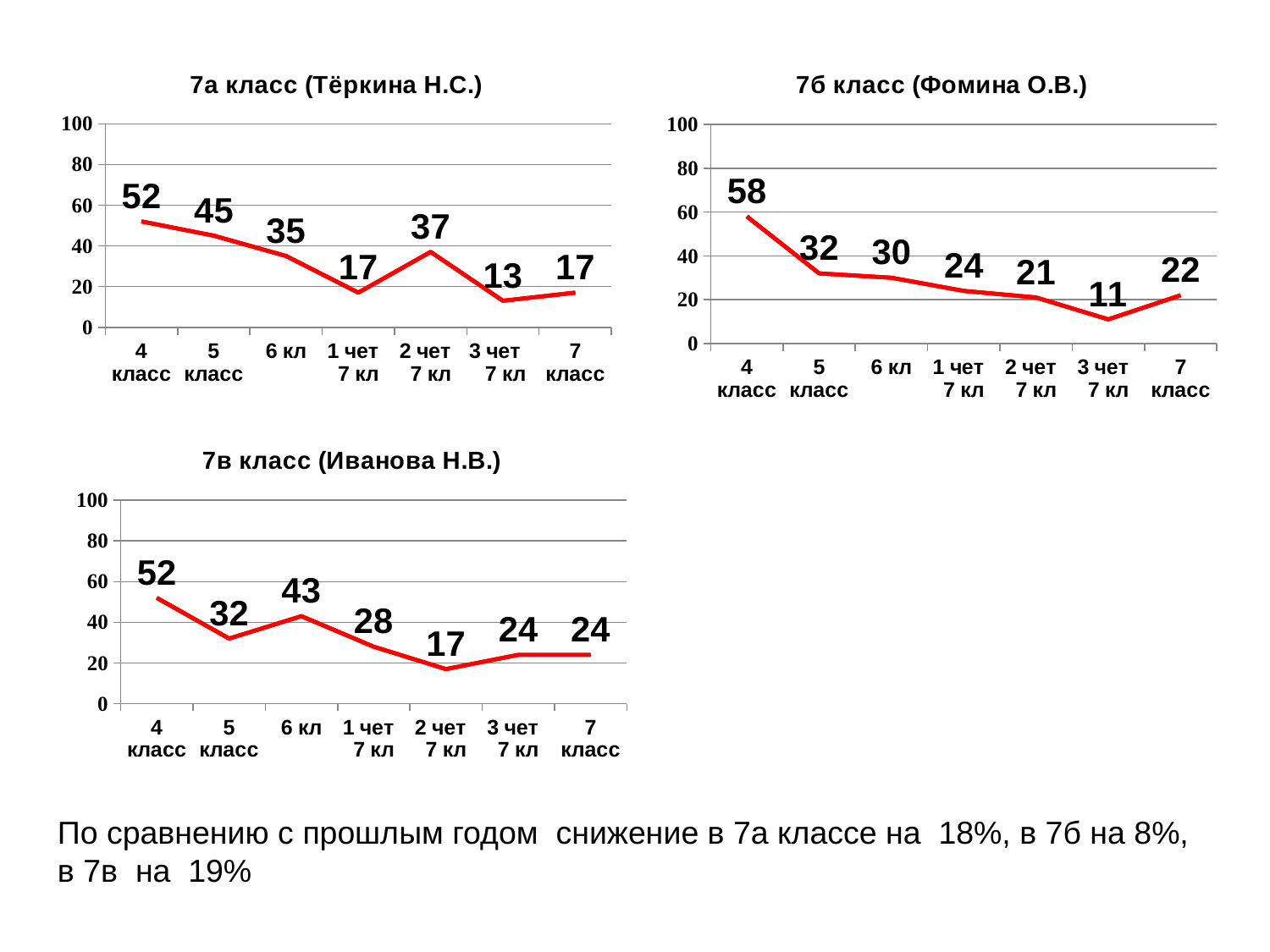
In the chart titled "7а класс (Тёркина Н.С.)", which is larger: the value for "5 класс" or the value for "6 кл"? 5 класс What kind of chart is the chart titled "7а класс (Тёркина Н.С.)"? line chart How many categories are shown on the x axis of the chart titled "7в класс (Иванова Н.В.)"? 7 In the chart titled "7в класс (Иванова Н.В.)", what is the difference between the values for "4 класс" and "7 класс"? 28 In the chart titled "7б класс (Фомина О.В.)", do the values generally rise or fall from "4 класс" to "3 чет 7 кл"? fall In the chart titled "7в класс (Иванова Н.В.)", what is the value for "6 кл"? 43 What colour is the line in the chart titled "7в класс (Иванова Н.В.)"? red In the chart titled "7а класс (Тёркина Н.С.)", what is the value for "2 чет 7 кл"? 37 In the chart titled "7б класс (Фомина О.В.)", which category has the lowest value? 3 чет 7 кл In the chart titled "7а класс (Тёркина Н.С.)", which category has the highest value? 4 класс In the chart titled "7б класс (Фомина О.В.)", what is the value for "4 класс"? 58 In the chart titled "7б класс (Фомина О.В.)", is the value for "4 класс" greater or less than 40? greater